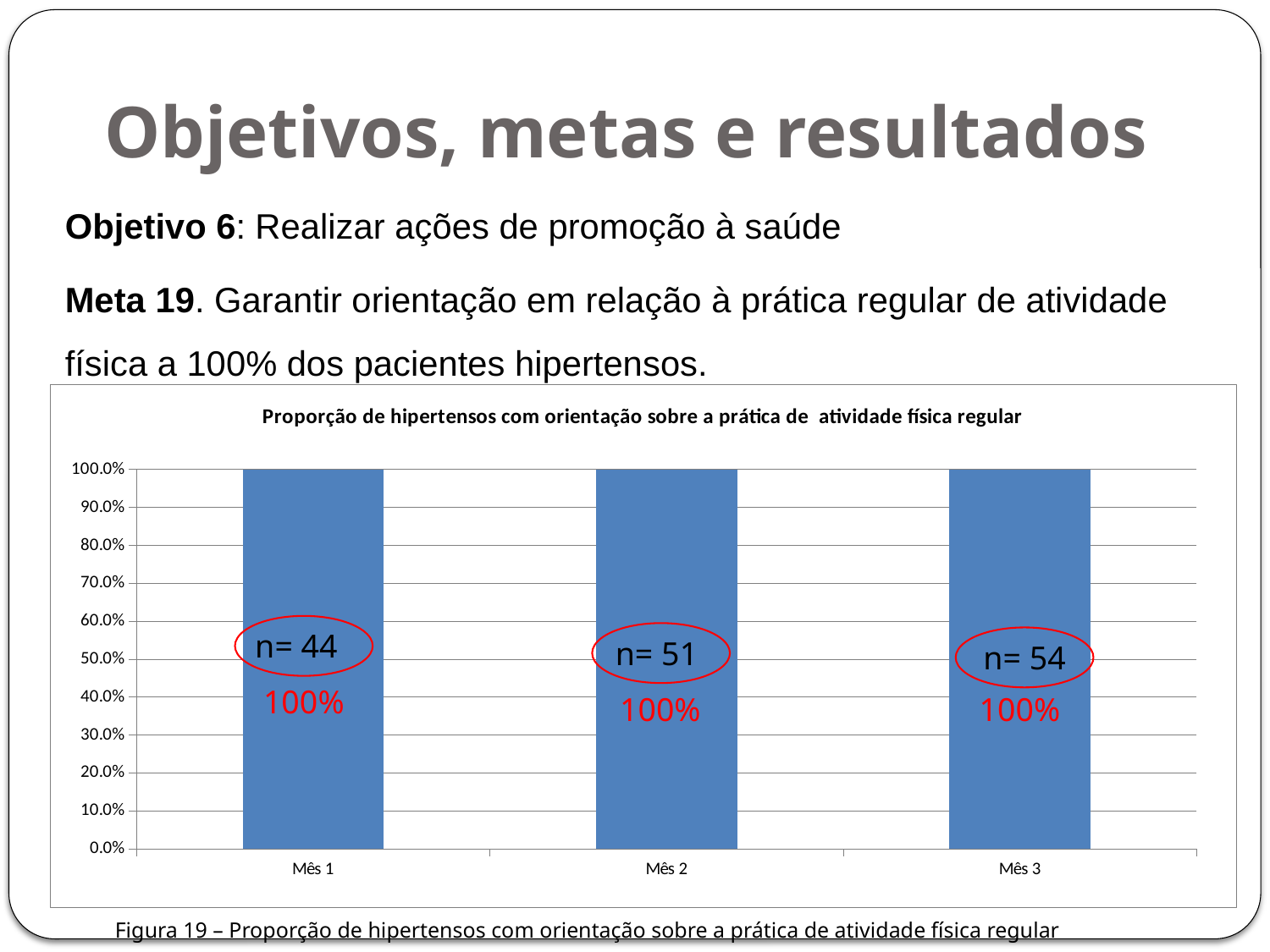
How many categories are shown on the x axis? 3 What is the n value annotated on the bar for Mês 3? n= 54 What is the title of the chart? Proporção de hipertensos com orientação sobre a prática de atividade física regular What is the value for Mês 1? 100% Is the value for Mês 2 greater or less than 50.0%? greater What colour are the bars? Blue What is the value for Mês 3? 100% Do the values rise, fall or stay the same from Mês 1 to Mês 3? Stay the same What kind of chart is shown? Bar chart What is the value for Mês 2? 100% What is the n value annotated on the bar for Mês 2? n= 51 What is the n value annotated on the bar for Mês 1? n= 44